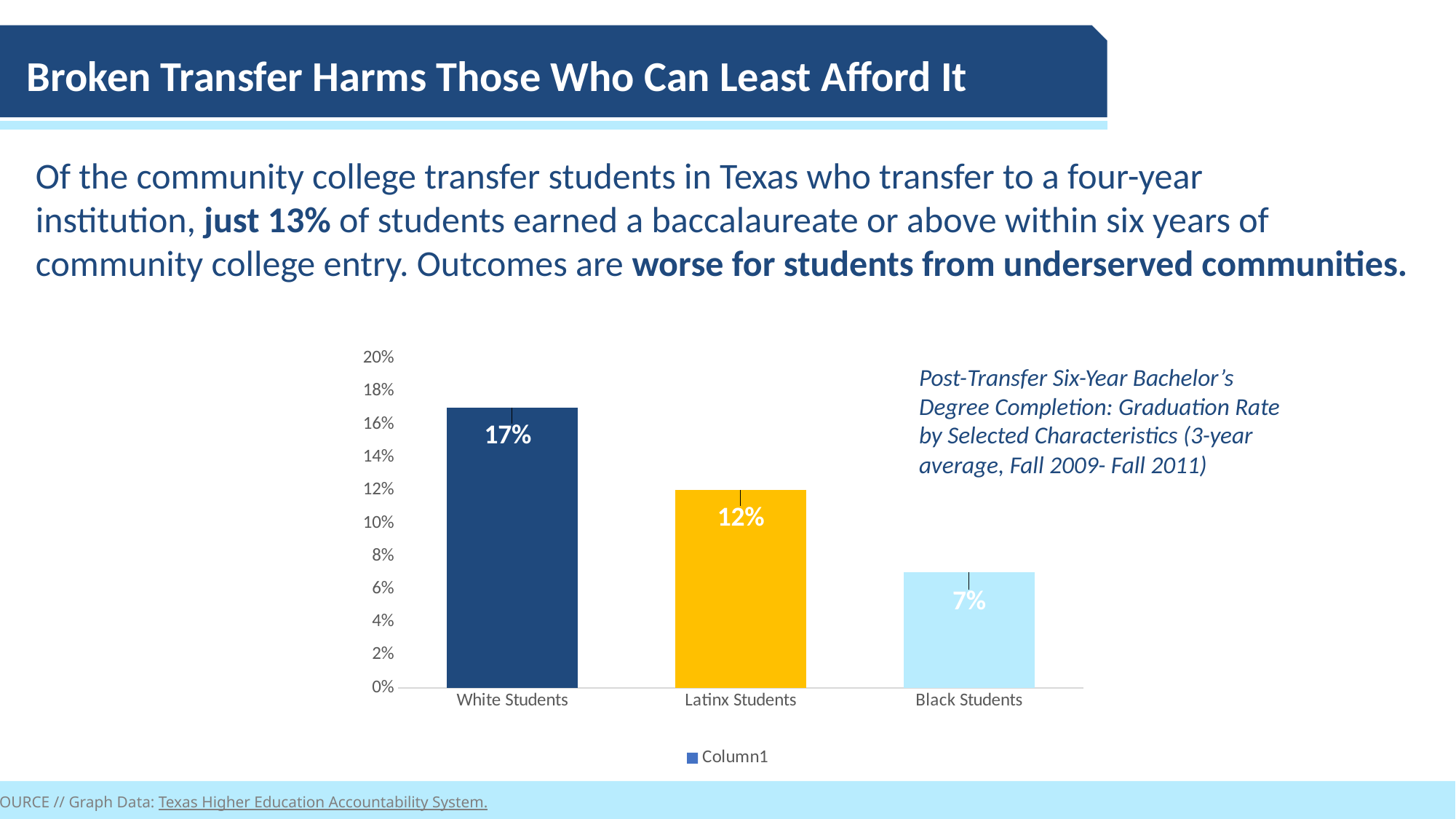
How many categories are shown on the chart? 3 What is the difference between the values for White Students and Black Students? 10% Which category has the lowest value? Black Students Which category has the highest value? White Students What is the value for Black Students? 7% What is the difference between the values for Latinx Students and Black Students? 5% What is the legend entry shown below the chart? Column1 What is the value for White Students? 17% What is the value for Latinx Students? 12% What kind of chart is shown on the slide? bar chart Is the value for White Students greater or less than 10%? greater Which is larger, the value for Latinx Students or the value for Black Students? Latinx Students